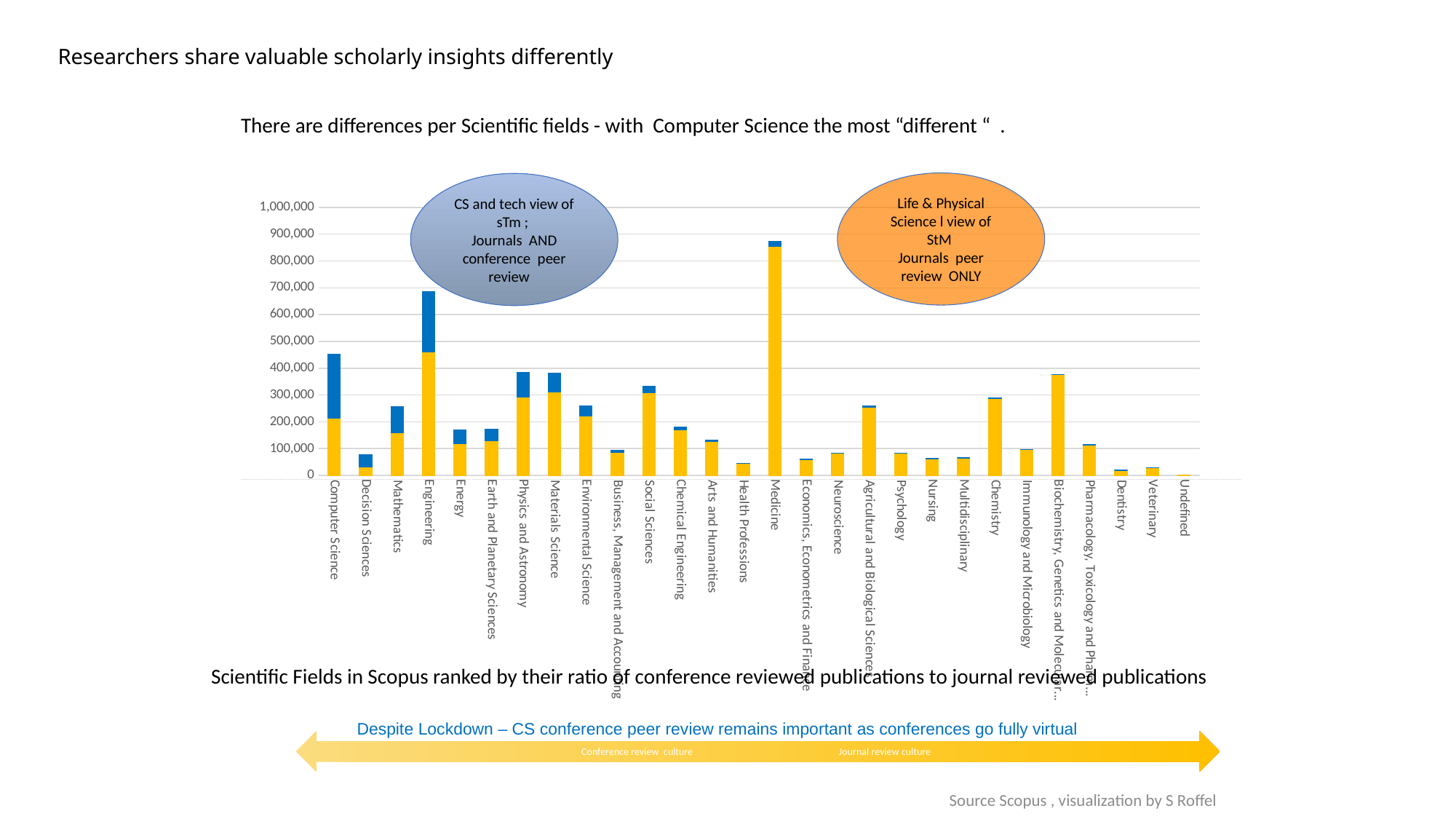
Which scientific field has the shortest bar in the chart? Undefined What is the caption below the chart describing what it shows? Scientific Fields in Scopus ranked by their ratio of conference reviewed publications to journal reviewed publications Is the total bar for Decision Sciences greater or less than 100,000? less How many scientific fields (categories) are plotted on the x axis of the chart? 28 What kind of chart is shown on the slide? Stacked bar chart Which scientific field has the tallest bar in the chart? Medicine Is the total bar for Engineering greater or less than 600,000? greater Which has a taller bar, Medicine or Engineering? Medicine Is the total bar for Computer Science greater or less than 400,000? greater Which has a taller bar, Engineering or Computer Science? Engineering What is the highest value shown on the vertical axis of the chart? 1,000,000